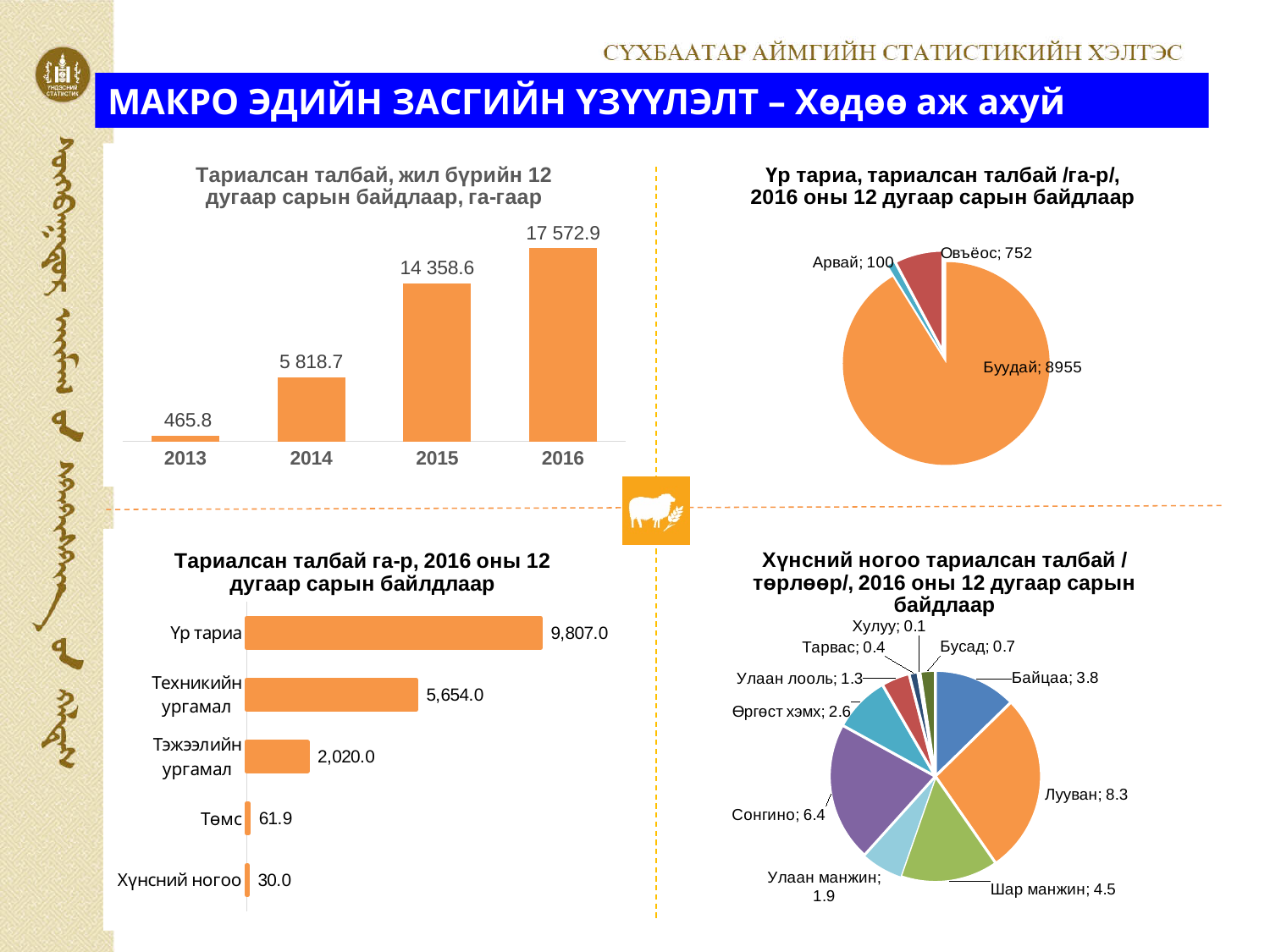
In the bottom-right pie chart 'Хүнсний ногоо тариалсан талбай /төрлөөр/', which is larger, Сонгино or Байцаа? Сонгино In the bottom-left chart 'Тариалсан талбай га-р, 2016 оны 12 дугаар сарын байдлаар', what is the value for Техникийн ургамал? 5,654.0 In the top-left chart 'Тариалсан талбай, жил бүрийн 12 дугаар сарын байдлаар, га-гаар', what is the value for 2016? 17 572.9 In the bottom-right pie chart 'Хүнсний ногоо тариалсан талбай /төрлөөр/', what is the value for Лууван? 8.3 In the top-right pie chart 'Үр тариа, тариалсан талбай /га-р/', what is the value for Буудай? 8955 In the top-left chart 'Тариалсан талбай, жил бүрийн 12 дугаар сарын байдлаар, га-гаар', what kind of chart is shown? bar chart In the top-left chart 'Тариалсан талбай, жил бүрийн 12 дугаар сарын байдлаар, га-гаар', do the values rise or fall from 2013 to 2016? rise In the top-right pie chart 'Үр тариа, тариалсан талбай /га-р/', how many slices are there? 3 In the top-left chart 'Тариалсан талбай, жил бүрийн 12 дугаар сарын байдлаар, га-гаар', which year has the lowest value? 2013 In the top-right pie chart 'Үр тариа, тариалсан талбай /га-р/', which category has the smallest slice? Арвай In the bottom-left chart 'Тариалсан талбай га-р, 2016 оны 12 дугаар сарын байдлаар', what is the difference between Төмс and Хүнсний ногоо? 31.9 In the bottom-left chart 'Тариалсан талбай га-р, 2016 оны 12 дугаар сарын байдлаар', which category has the highest value? Үр тариа